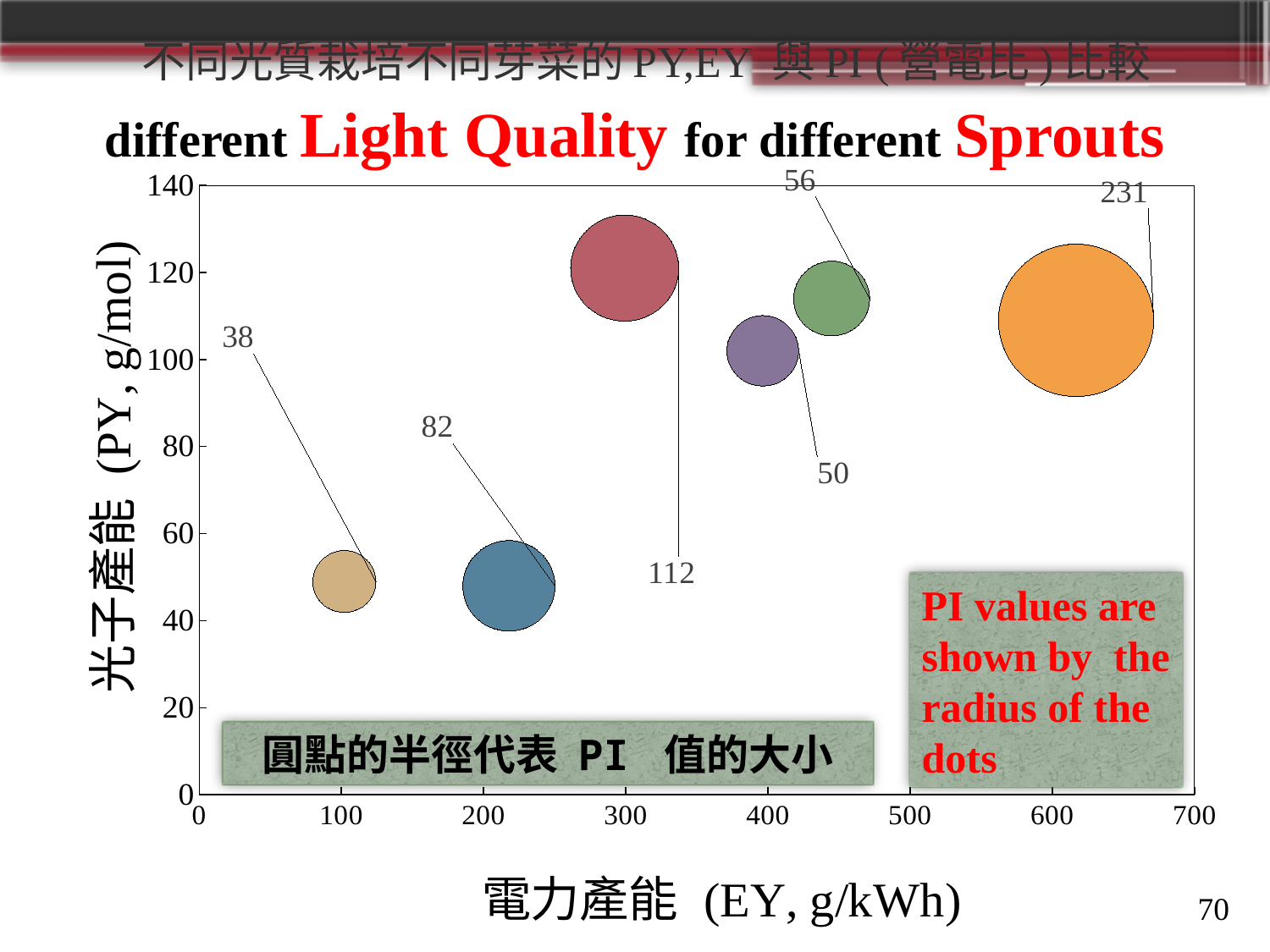
Which is larger, the PI value of the blue bubble or the PI value of the green bubble? the blue bubble (82) Which bubble has the lowest PI value label? the tan bubble (38) According to the text box on the chart, what does the radius of each dot represent? PI values What kind of chart is shown on the slide? bubble chart How many bubbles (data points) are plotted on the chart? 6 What is the difference between the largest PI label (231) and the smallest PI label (38)? 193 Which bubble has the highest PI value label? the orange bubble (231) Is the EY (x-axis) value of the orange bubble greater or less than 500? greater What is the PI value labelled on the green bubble? 56 What is the PI value labelled on the orange bubble? 231 Is the PY (y-axis) value of the tan bubble labelled 38 greater or less than 60? less What is the PI value labelled on the blue bubble? 82